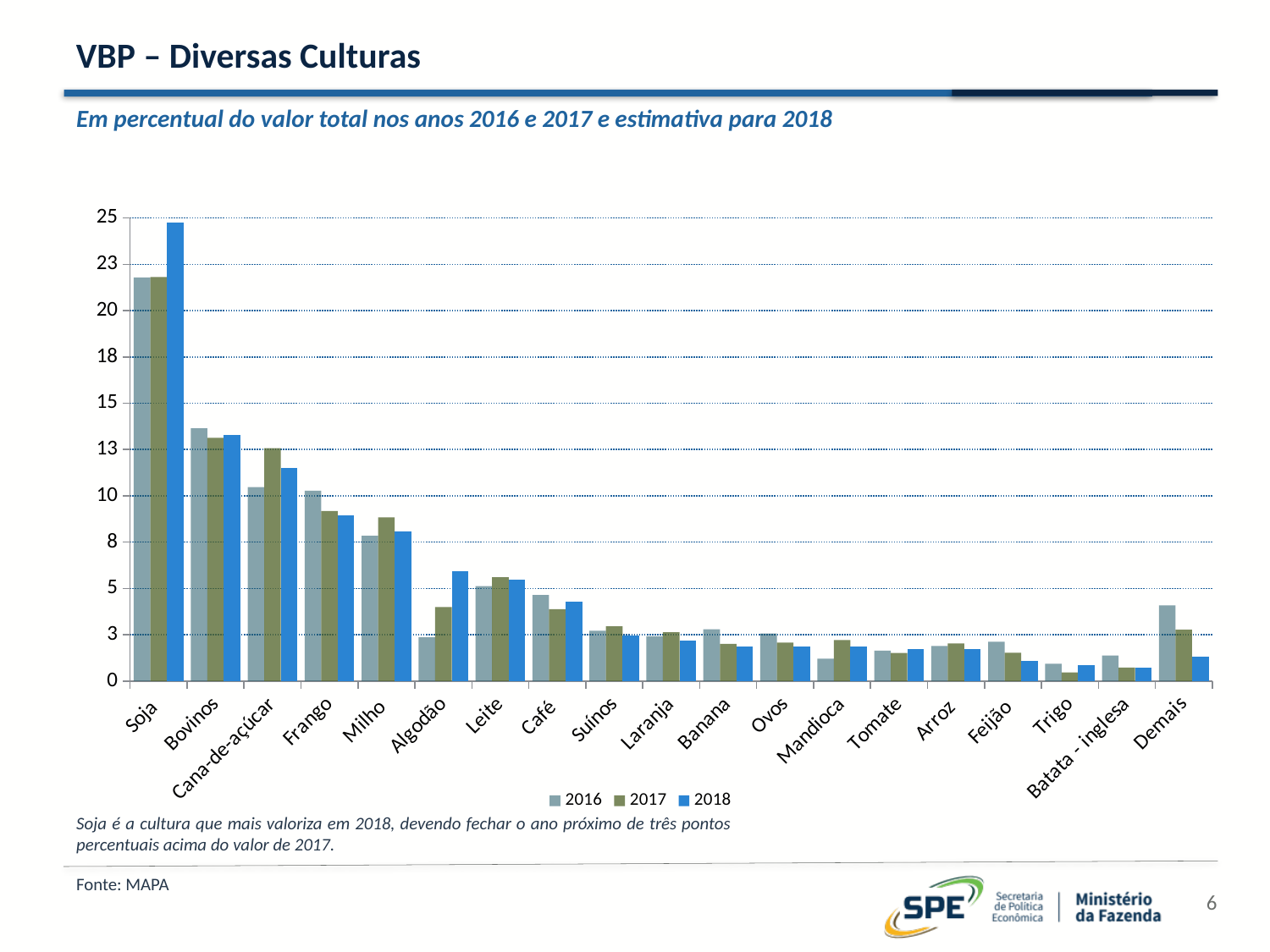
For Algodão, which is larger: the 2016 value or the 2018 value? 2018 What kind of chart is shown on the slide? bar chart Is the 2018 value for Algodão greater or less than 5? greater Is the 2016 value for Demais greater or less than 3? greater How many series does the legend list? 3 How many categories are shown on the x axis? 19 Which category has the highest 2018 value? Soja What is the title of the slide? VBP – Diversas Culturas Is the 2017 value for Milho greater or less than 8? greater For Cana-de-açúcar, which is larger: the 2017 value or the 2018 value? 2017